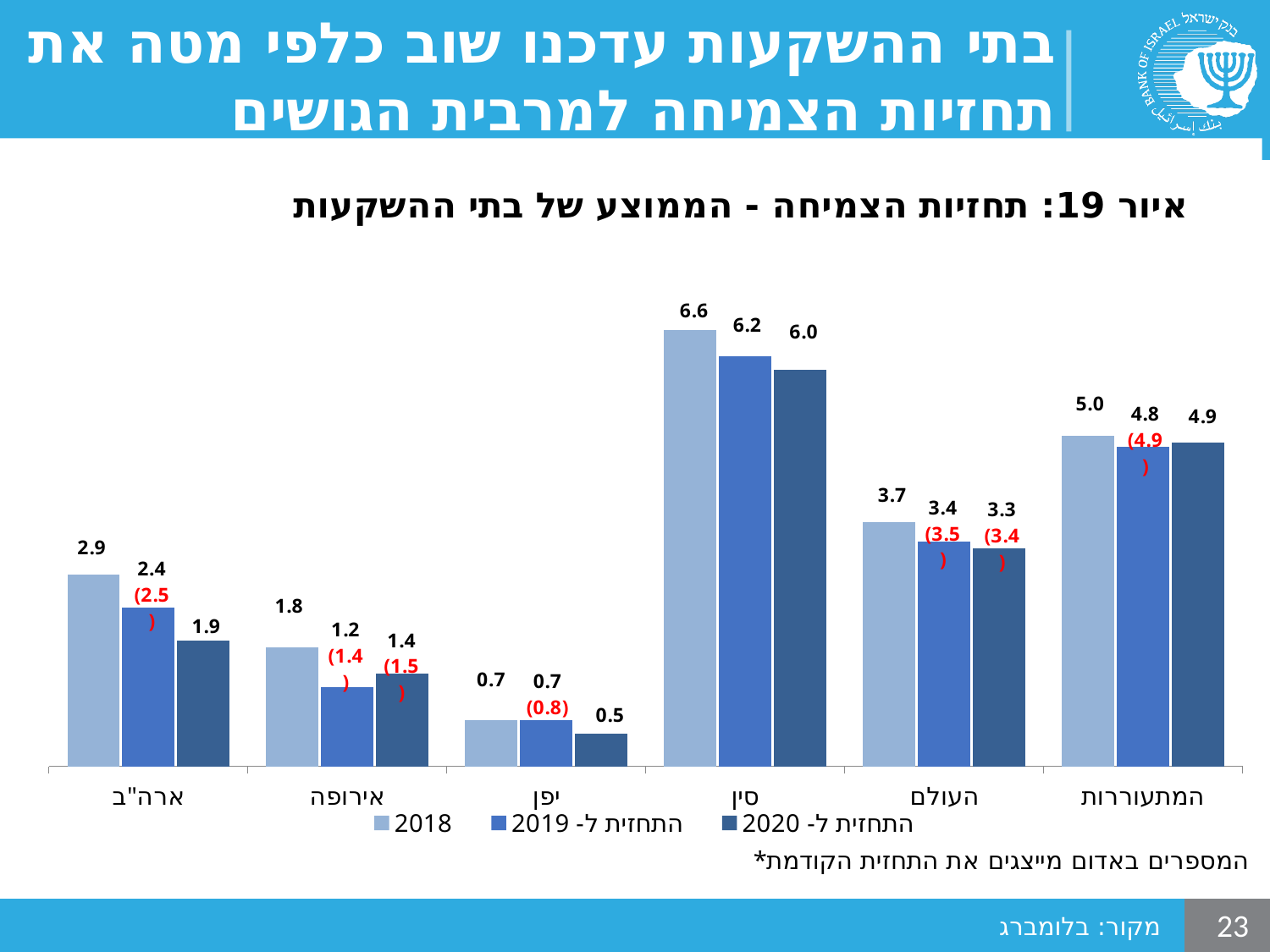
What is the difference between the 2018 value and the התחזית ל-2020 value for סין (China)? 0.6 What kind of chart is shown on the slide? Bar chart What is the התחזית ל-2020 (forecast for 2020) value for ארה"ב (USA)? 1.9 How many categories are shown on the x axis? 6 How many series does the legend list? 3 What is the התחזית ל-2019 (forecast for 2019) value for המתעוררות (emerging markets)? 4.8 What is the previous forecast (shown in red) for the 2019 value of אירופה (Europe)? (1.4) Which is larger for העולם (World): the 2018 value or the התחזית ל-2019 value? 2018 What is the 2018 value for סין (China)? 6.6 Do the values for ארה"ב (USA) rise or fall from 2018 to the 2020 forecast? Fall Which category has the highest 2018 value? סין Which category has the lowest התחזית ל-2020 (forecast for 2020) value? יפן